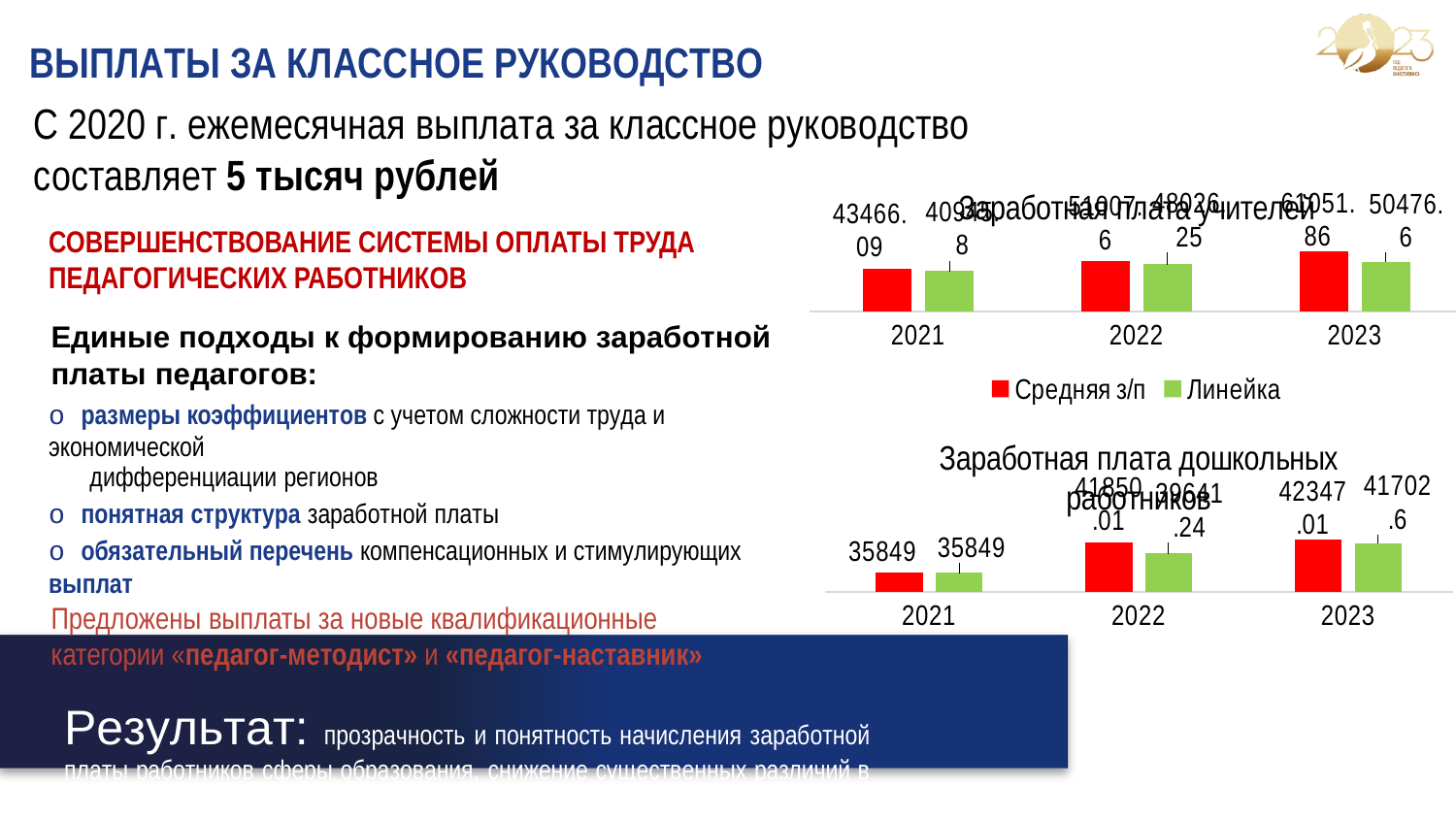
In the bottom chart 'Заработная плата дошкольных работников', which year has the lowest value for the red bars? 2021 In the top chart 'Заработная плата учителей', which year has the highest 'Средняя з/п'? 2023 In the top chart 'Заработная плата учителей', what is the value of 'Линейка' for 2023? 50476.6 In the bottom chart 'Заработная плата дошкольных работников', what is the value of the red bar for 2021? 35849 In the top chart 'Заработная плата учителей', how many series does the legend list? 2 In the bottom chart 'Заработная плата дошкольных работников', what is the value of the green bar for 2023? 41702.6 In the top chart 'Заработная плата учителей', what are the two legend entries? Средняя з/п, Линейка What kind of chart is the top chart, 'Заработная плата учителей'? bar chart In the top chart 'Заработная плата учителей', what is the value of 'Средняя з/п' for 2021? 43466.09 In the bottom chart 'Заработная плата дошкольных работников', what is the value of the red bar for 2023? 42347.01 In the top chart 'Заработная плата учителей', does 'Средняя з/п' rise or fall from 2021 to 2023? rise In the top chart 'Заработная плата учителей', how many years are shown on the x axis? 3